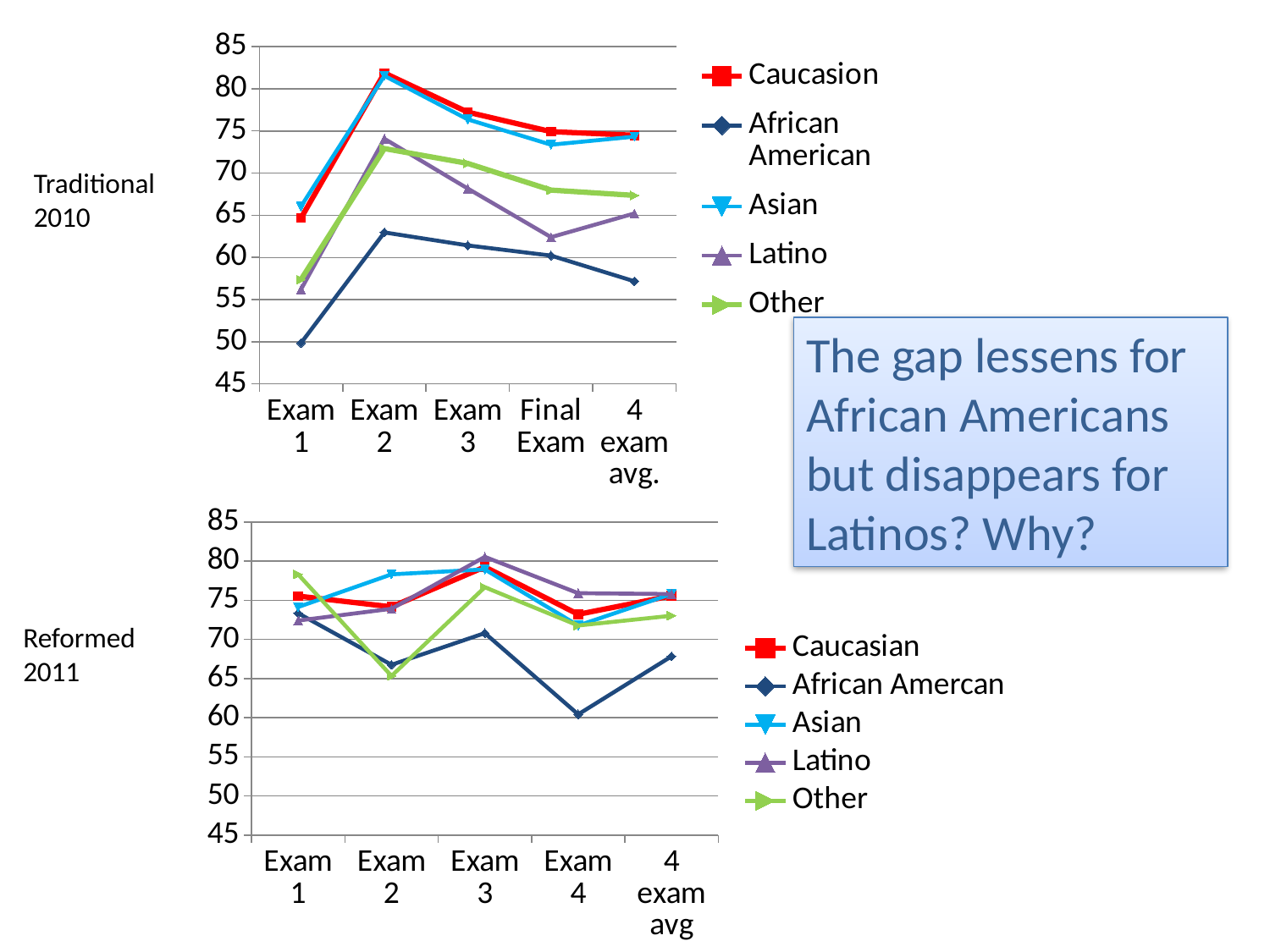
In the Traditional 2010 chart, is the Caucasion value for Exam 2 greater or less than 80? greater In the Reformed 2011 chart, which is larger at Exam 4: the Latino value or the Caucasian value? Latino In the Reformed 2011 chart, is the Other value for Exam 1 greater or less than 75? greater In the Traditional 2010 chart, which series has the lowest value at Exam 1? African American In the Reformed 2011 chart, is the African Amercan value for Exam 4 greater or less than 65? less How many categories are shown on the x axis of the Reformed 2011 chart? 5 In the Reformed 2011 chart, which series has the lowest value at Exam 4? African Amercan How many series does the legend of the Traditional 2010 chart list? 5 In the Traditional 2010 chart, does the African American line rise or fall from Exam 2 to the 4 exam avg.? fall What type of chart is the Traditional 2010 chart at the top of the slide? line chart